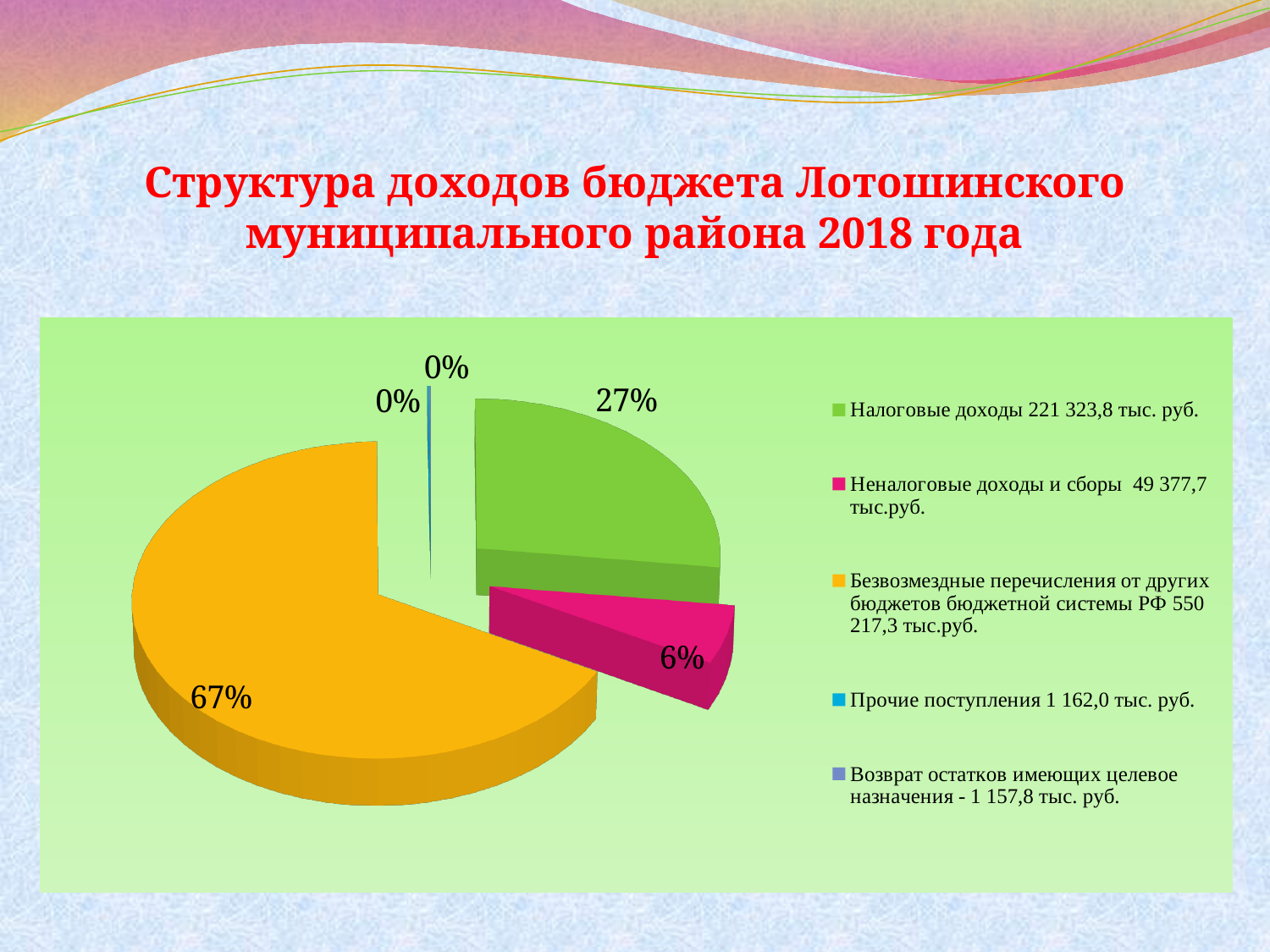
How many categories are shown in the pie chart? 5 How many entries does the legend list? 5 What kind of chart is shown on the slide? pie chart What is the difference in percentage points between the share for "Безвозмездные перечисления" and the share for "Налоговые доходы"? 40 percentage points What share of the pie does "Прочие поступления" represent? 0% What share of the pie does "Налоговые доходы" represent? 27% What share of the pie does "Неналоговые доходы и сборы" represent? 6% What amount is given in the legend for "Налоговые доходы"? 221 323,8 тыс. руб. What is the title of the slide? Структура доходов бюджета Лотошинского муниципального района 2018 года Which is larger: the share for "Налоговые доходы" or the share for "Неналоговые доходы и сборы"? Налоговые доходы Which category has the largest slice of the pie? Безвозмездные перечисления от других бюджетов бюджетной системы РФ